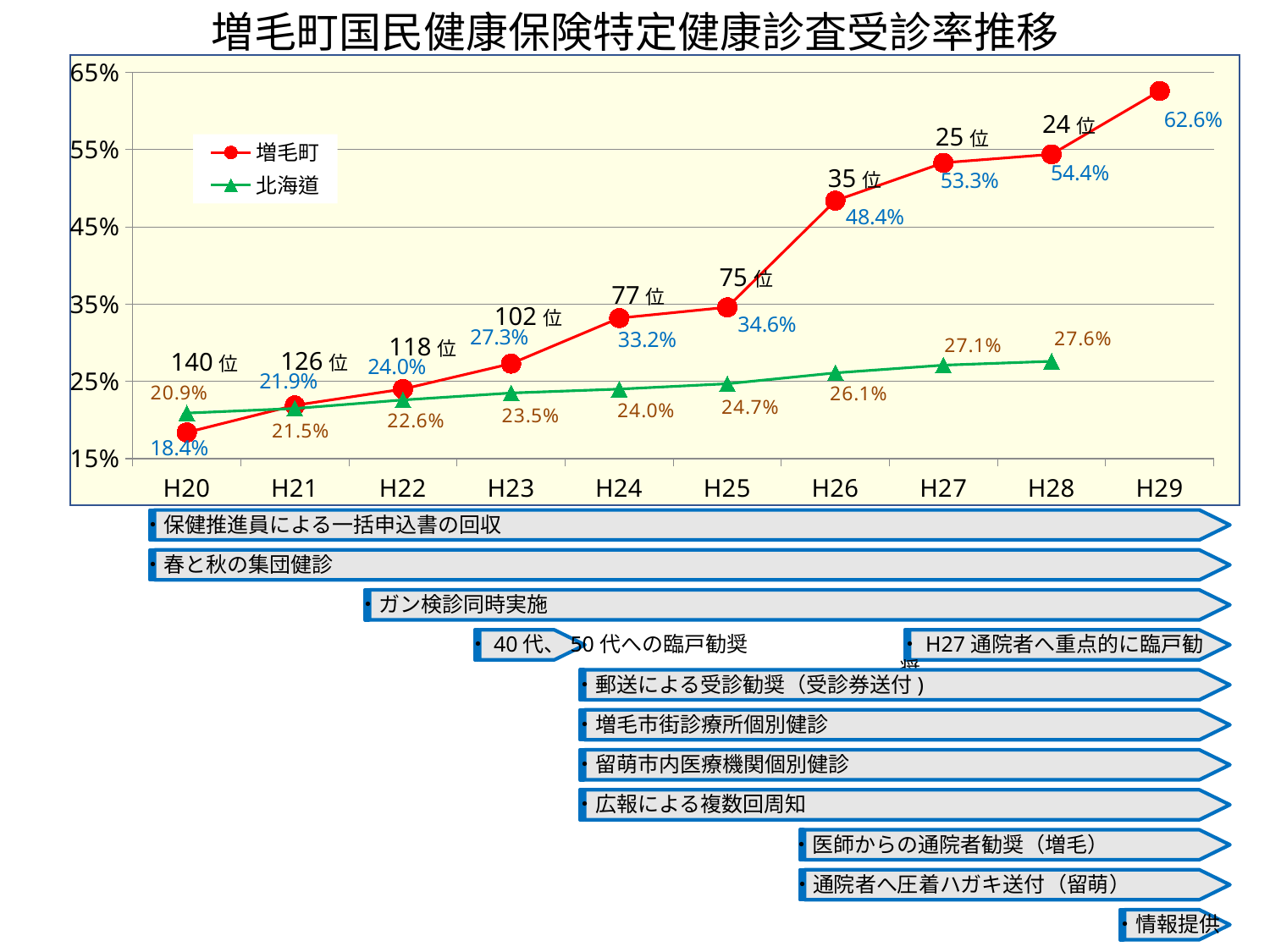
In which year is the value for 増毛町 the highest? H29 What ranking (位) is shown for 増毛町 in H26? 35位 What type of chart is shown on the slide? line chart What is the value for 北海道 in H28? 27.6% In which year is the value for 増毛町 the lowest? H20 What is the difference between 増毛町 and 北海道 in H28? 26.8% Does the value for 増毛町 rise or fall from H20 to H29? rise How many years are shown on the x axis? 10 How many series does the legend list? 2 Which is larger in H20, the value for 増毛町 or for 北海道? 北海道 What is the value for 増毛町 in H29? 62.6% What is the value for 増毛町 in H20? 18.4%